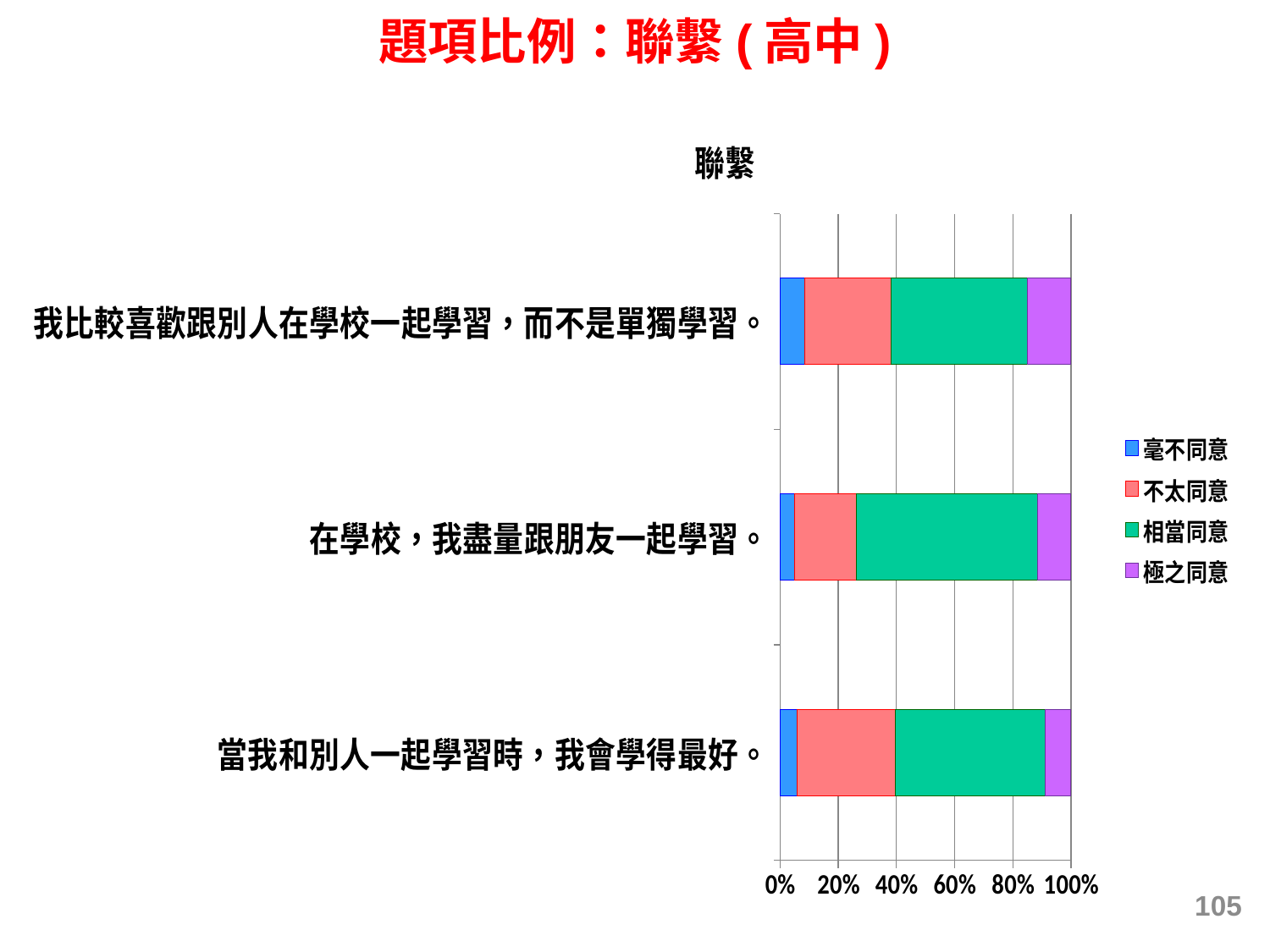
Is the 相當同意 share for 「在學校，我盡量跟朋友一起學習。」 greater or less than 40%? greater How many statements (categories) are plotted in the chart? 3 What is the total of each stacked bar, as shown by where the bars end on the axis? 100% Which response category takes the smallest share of the bar for 「我比較喜歡跟別人在學校一起學習，而不是單獨學習。」? 毫不同意 Which statement has the largest 相當同意 share? 在學校，我盡量跟朋友一起學習。 How many series does the legend list? 4 What kind of chart is shown on the slide? Stacked bar chart Which legend entry is shown in green? 相當同意 Which response category takes the largest share of the bar for 「在學校，我盡量跟朋友一起學習。」? 相當同意 Which statement has the larger 不太同意 share: 「在學校，我盡量跟朋友一起學習。」 or 「當我和別人一起學習時，我會學得最好。」? 當我和別人一起學習時，我會學得最好。 What is the title shown above the chart? 聯繫 Is the 毫不同意 share for 「當我和別人一起學習時，我會學得最好。」 greater or less than 20%? less